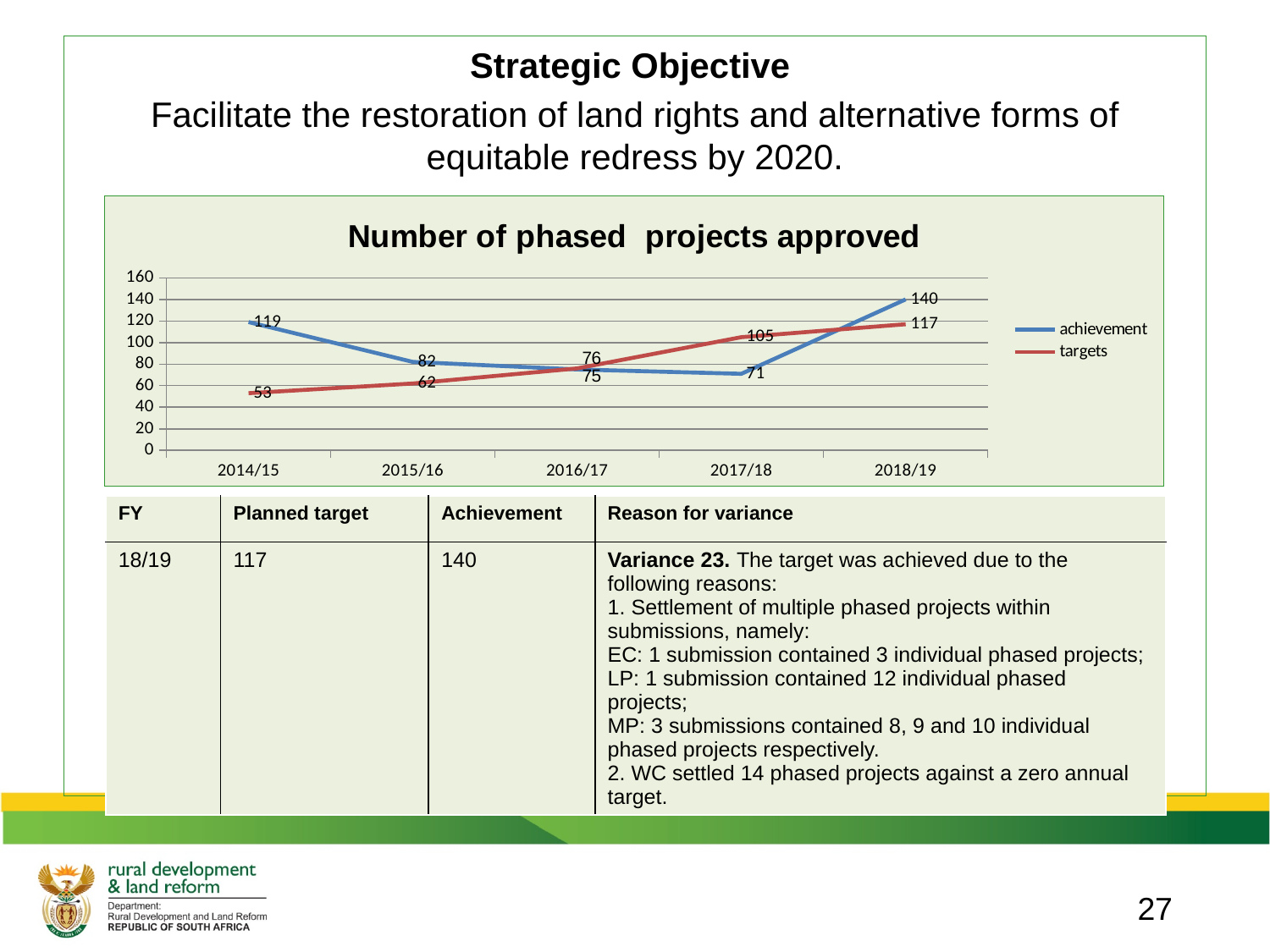
In which year is the achievement series at its lowest? 2017/18 What is the achievement value for 2017/18? 71 Does the targets series rise or fall from 2014/15 to 2018/19? rise What is the achievement value for 2018/19? 140 How many financial years are plotted on the x axis of the chart? 5 What is the difference between the achievement and the target in 2018/19? 23 Which is larger in 2014/15, the achievement or the target? achievement What is the title of the chart? Number of phased projects approved How many series does the chart legend list? 2 In which year is the targets series at its highest? 2018/19 What type of chart is shown on the slide? line chart What is the targets value for 2014/15? 53